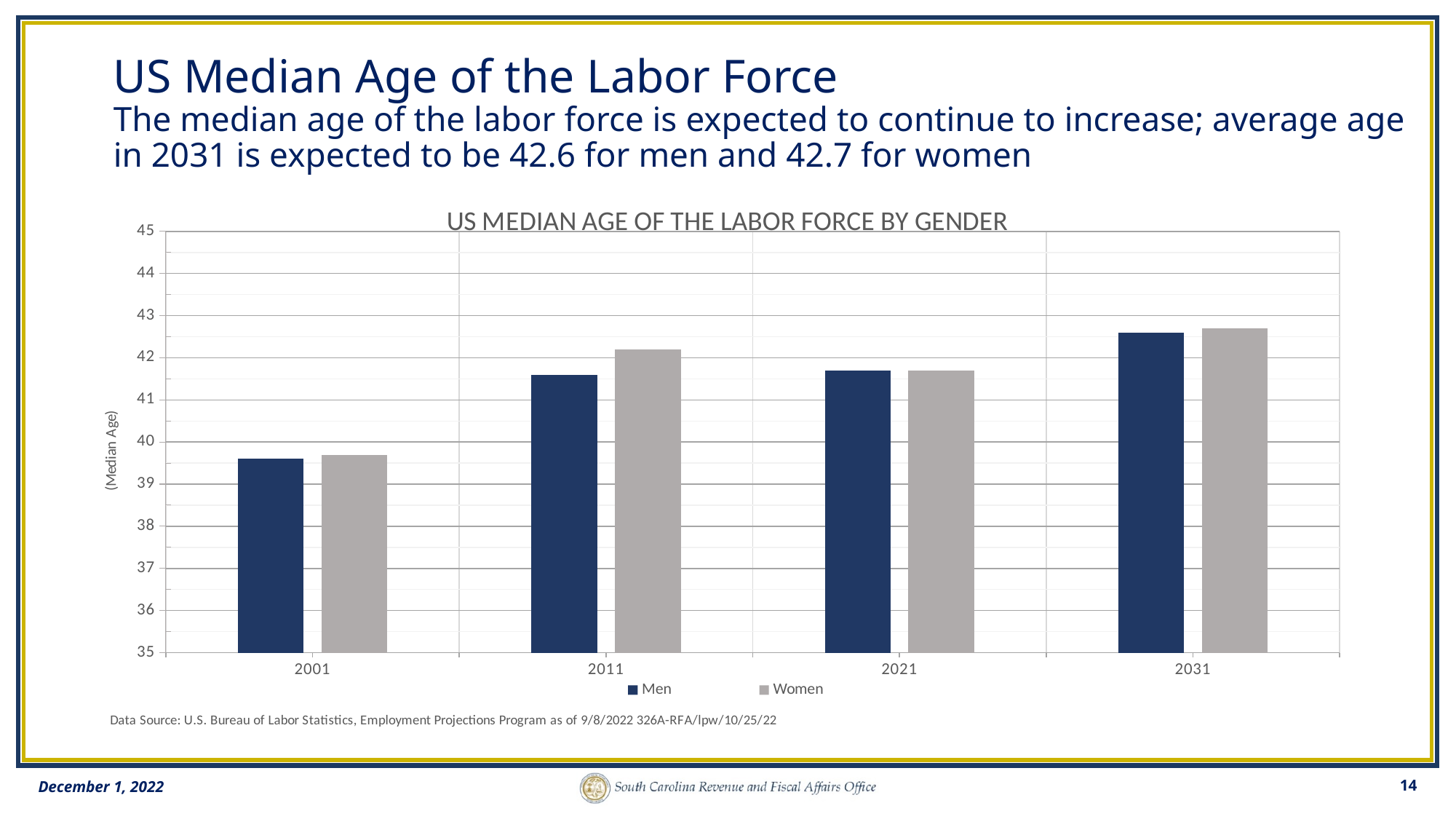
What kind of chart is shown on the slide? bar chart How many series does the legend list in the chart? 2 Is the median age for women in 2001 greater or less than 39? greater Do the median age values rise or fall from 2001 to 2031? rise What is the difference between the expected 2031 median age for women and for men? 0.1 Is the median age for men in 2021 greater or less than 42? less What is the expected median age for men in 2031? 42.6 Which year has the lowest median age for men? 2001 Is the median age for men in 2001 greater or less than 40? less How many years are shown on the x axis of the chart? 4 What is the expected median age for women in 2031? 42.7 In 2011, which is larger, the median age for men or for women? Women